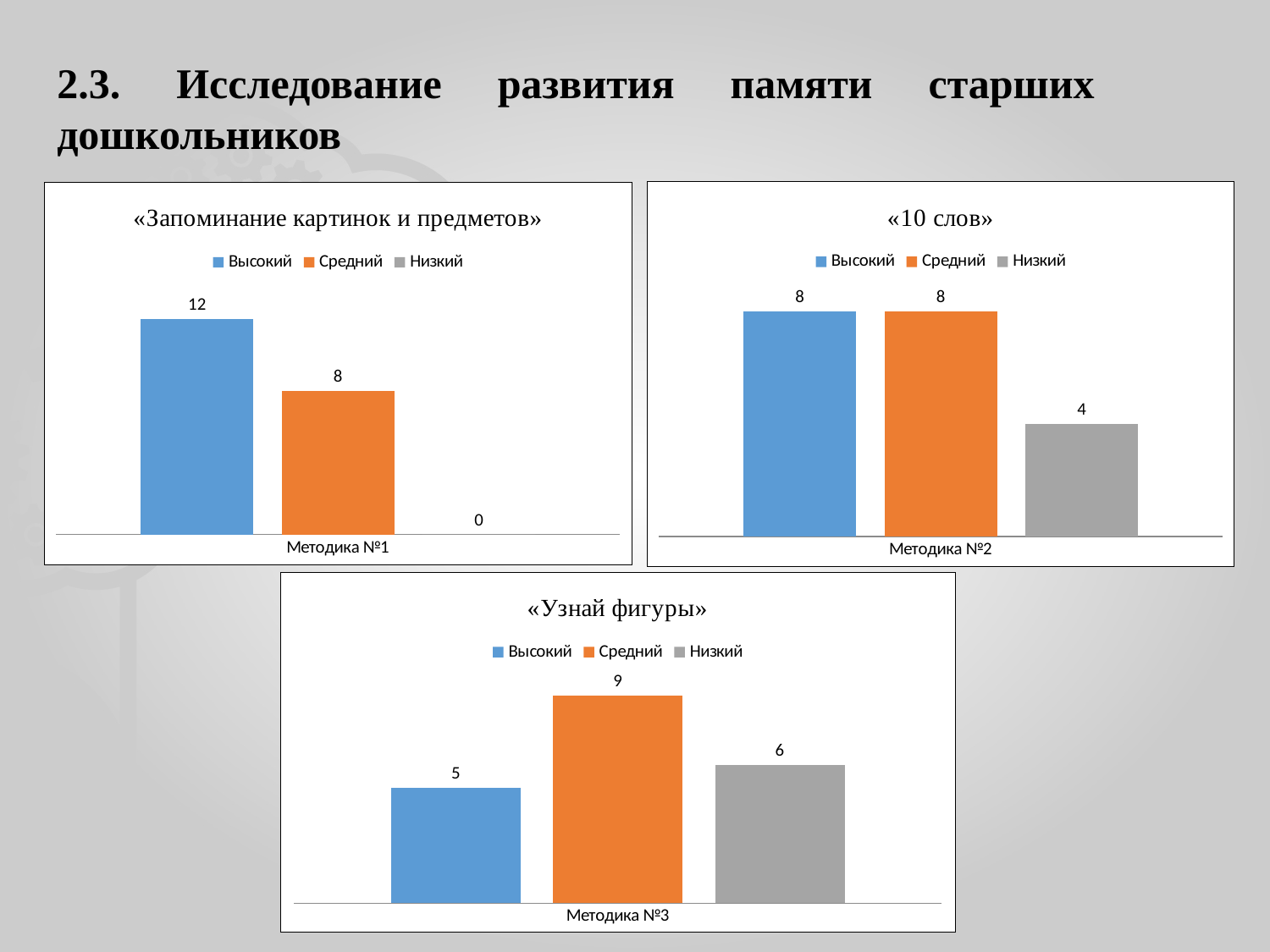
In the «Узнай фигуры» chart, what is the value for Высокий? 5 In the «Узнай фигуры» chart, what is the total of the three values? 20 In the «10 слов» chart, what is the difference between Средний and Низкий? 4 How many series does the legend of the «10 слов» chart list? 3 In the «Запоминание картинок и предметов» chart, what is the value for Высокий? 12 In the «10 слов» chart, which series has the lowest value? Низкий In the «Узнай фигуры» chart, which series has the highest value? Средний In the «Запоминание картинок и предметов» chart, what is the difference between Высокий and Средний? 4 In the «10 слов» chart, what is the value for Низкий? 4 What kind of chart is the «Узнай фигуры» chart? Bar chart In the «Запоминание картинок и предметов» chart, what is the value for Низкий? 0 In the «Узнай фигуры» chart, which is larger, Низкий or Высокий? Низкий